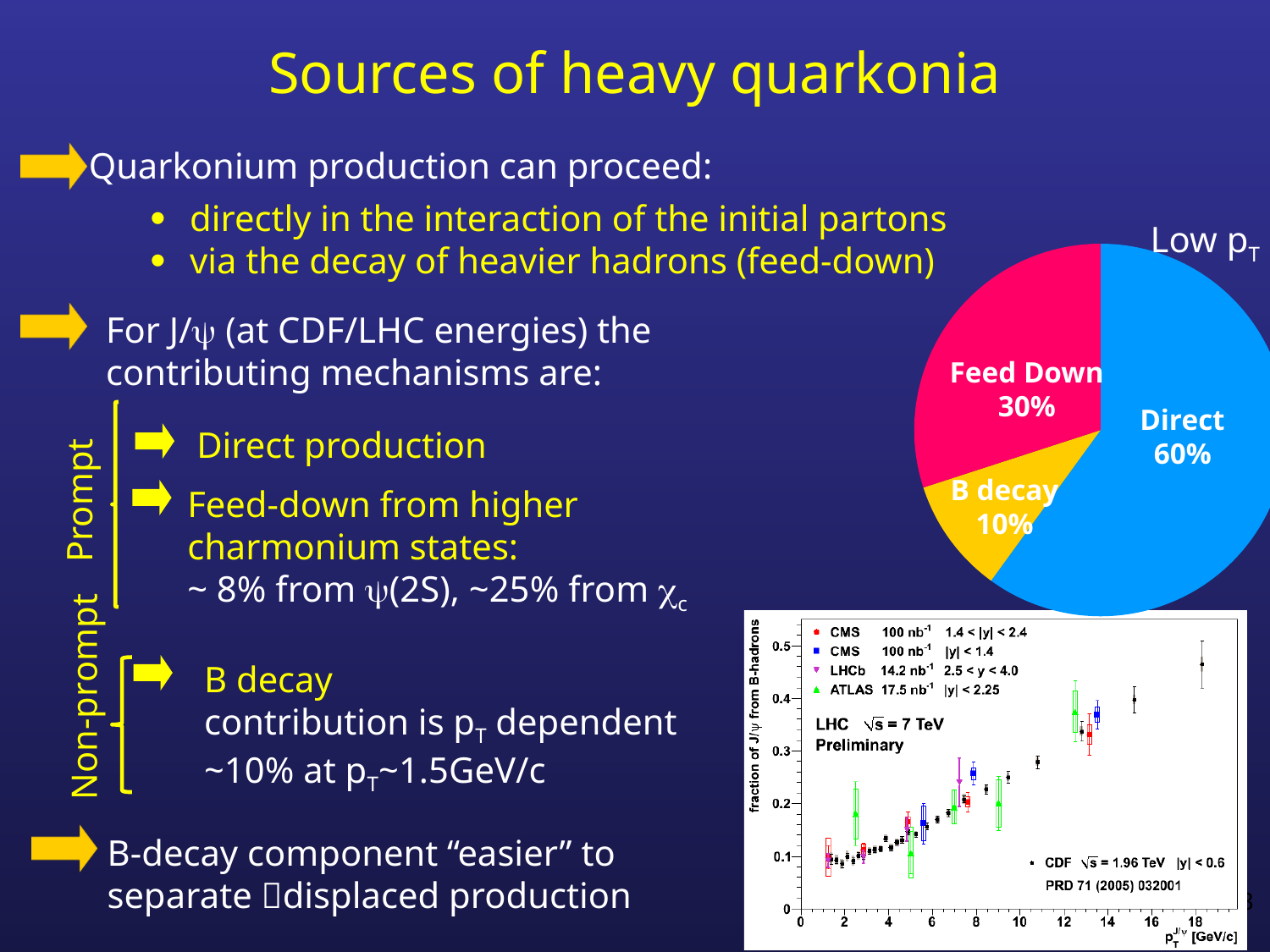
In the pie chart, what share is labelled Feed Down? 30% In the scatter plot at the bottom right, what quantity is on the x axis? pT J/ψ [GeV/c] In the pie chart, which slice is the smallest? B decay What kind of chart is the one in the upper right of the slide showing Direct, Feed Down and B decay? pie chart In the pie chart, which is larger, Feed Down or B decay? Feed Down In the pie chart, how many slices are there? 3 In the pie chart, what label appears above the chart at the top right? Low pT In the pie chart, which slice is the largest? Direct In the pie chart, what share is labelled B decay? 10% In the scatter plot at the bottom right, does the fraction of J/ψ from B-hadrons rise or fall as pT increases? rise In the pie chart, what is the difference between the Direct and Feed Down shares? 30% In the pie chart, what share is labelled Direct? 60%